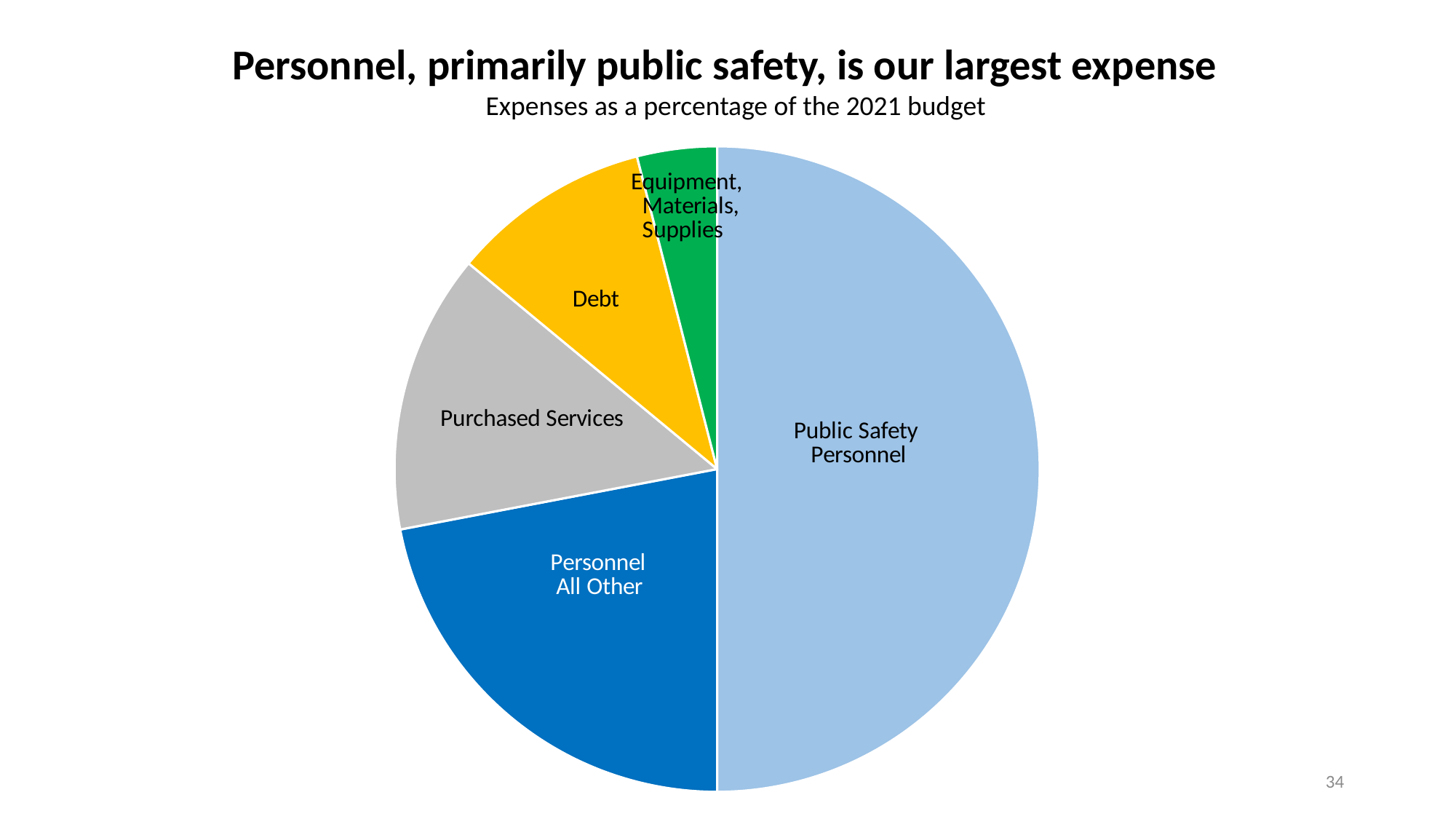
How many slices does the pie chart have? 5 Which slice is larger: Purchased Services or Equipment, Materials, Supplies? Purchased Services What does the subtitle say the chart shows? Expenses as a percentage of the 2021 budget Which slice is larger: Public Safety Personnel or Personnel All Other? Public Safety Personnel Which expense category is the smallest slice of the pie chart? Equipment, Materials, Supplies What is the title of the slide? Personnel, primarily public safety, is our largest expense Which expense category is the largest slice of the pie chart? Public Safety Personnel What kind of chart is shown on the slide? Pie chart Which slice is larger: Personnel All Other or Purchased Services? Personnel All Other